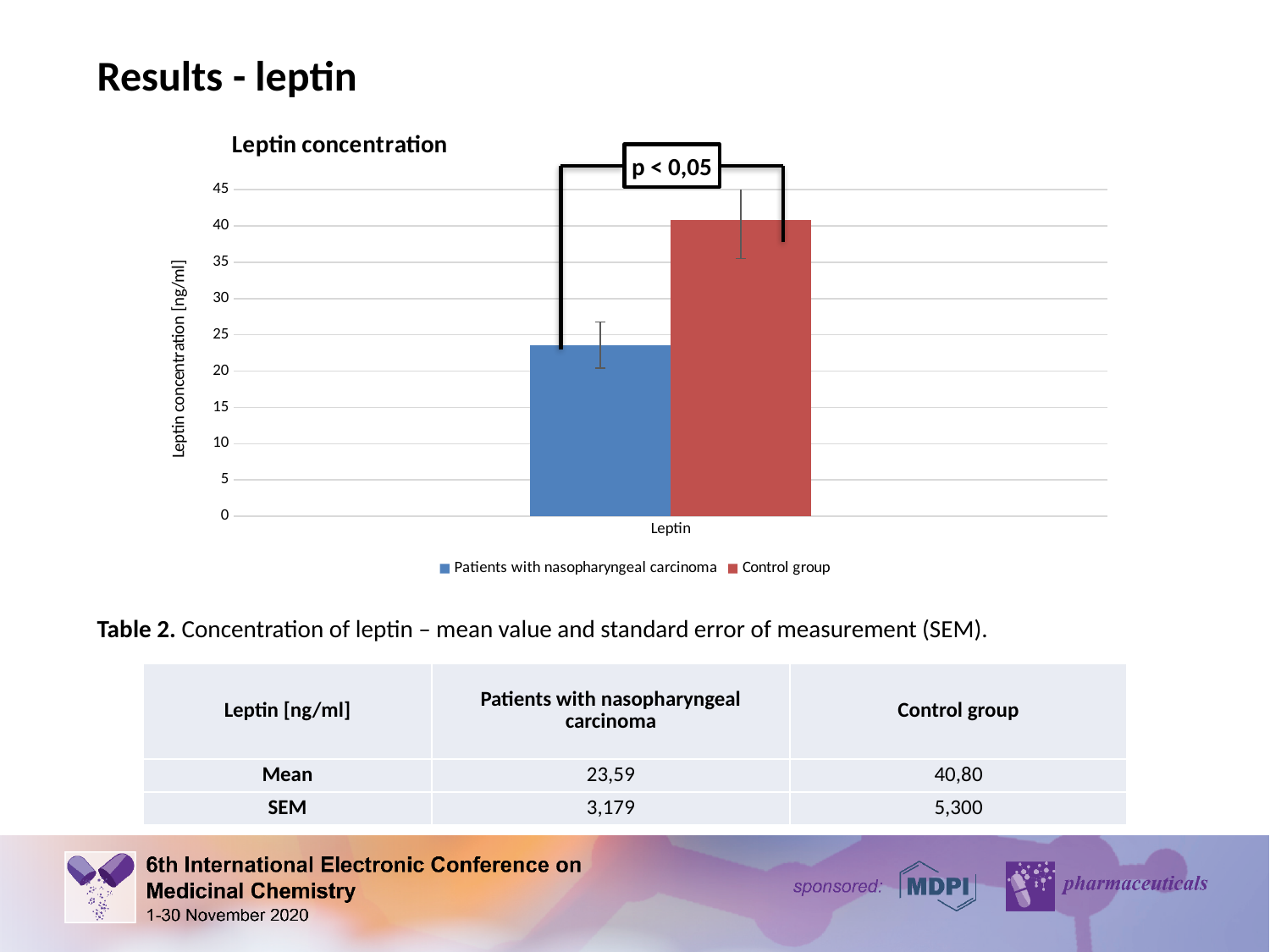
What is the title of the chart? Leptin concentration Is the bar for the Control group larger or smaller than the bar for Patients with nasopharyngeal carcinoma? larger What is the mean leptin concentration for the Control group, as given on the slide? 40,80 Which series has the higher leptin concentration in the chart? Control group Which series has the lower leptin concentration in the chart? Patients with nasopharyngeal carcinoma What is the mean leptin concentration for Patients with nasopharyngeal carcinoma, as given on the slide? 23,59 What kind of chart is shown on the slide? bar chart Is the leptin concentration bar for Patients with nasopharyngeal carcinoma greater or less than 25? less Is the leptin concentration bar for the Control group greater or less than 35? greater How many categories are shown on the x axis of the chart? 1 How many series does the chart legend list? 2 What p-value annotation is shown above the bars in the chart? p < 0,05